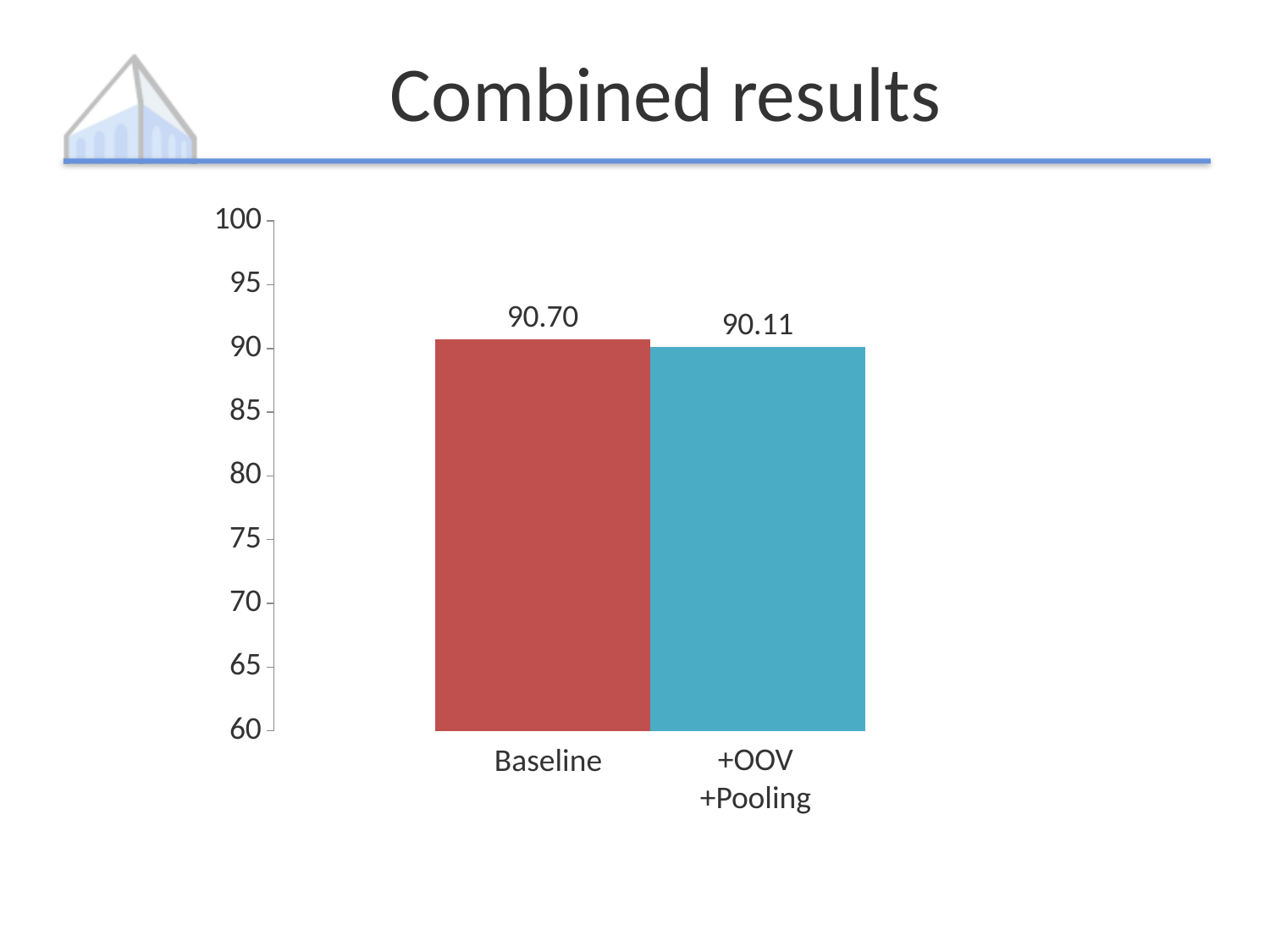
Which category has the highest value? Baseline What is the title of the slide containing the chart? Combined results Is the value for Baseline greater or less than 95? less How many categories are shown on the x axis? 2 Which is larger, the value for Baseline or the value for +OOV +Pooling? Baseline What is the difference between the Baseline value and the +OOV +Pooling value? 0.59 What is the value for Baseline? 90.70 What kind of chart is shown on the slide? bar chart Which category has the lowest value? +OOV +Pooling What is the value for +OOV +Pooling? 90.11 Is the value for +OOV +Pooling greater or less than 85? greater What colour is the bar for +OOV +Pooling? blue